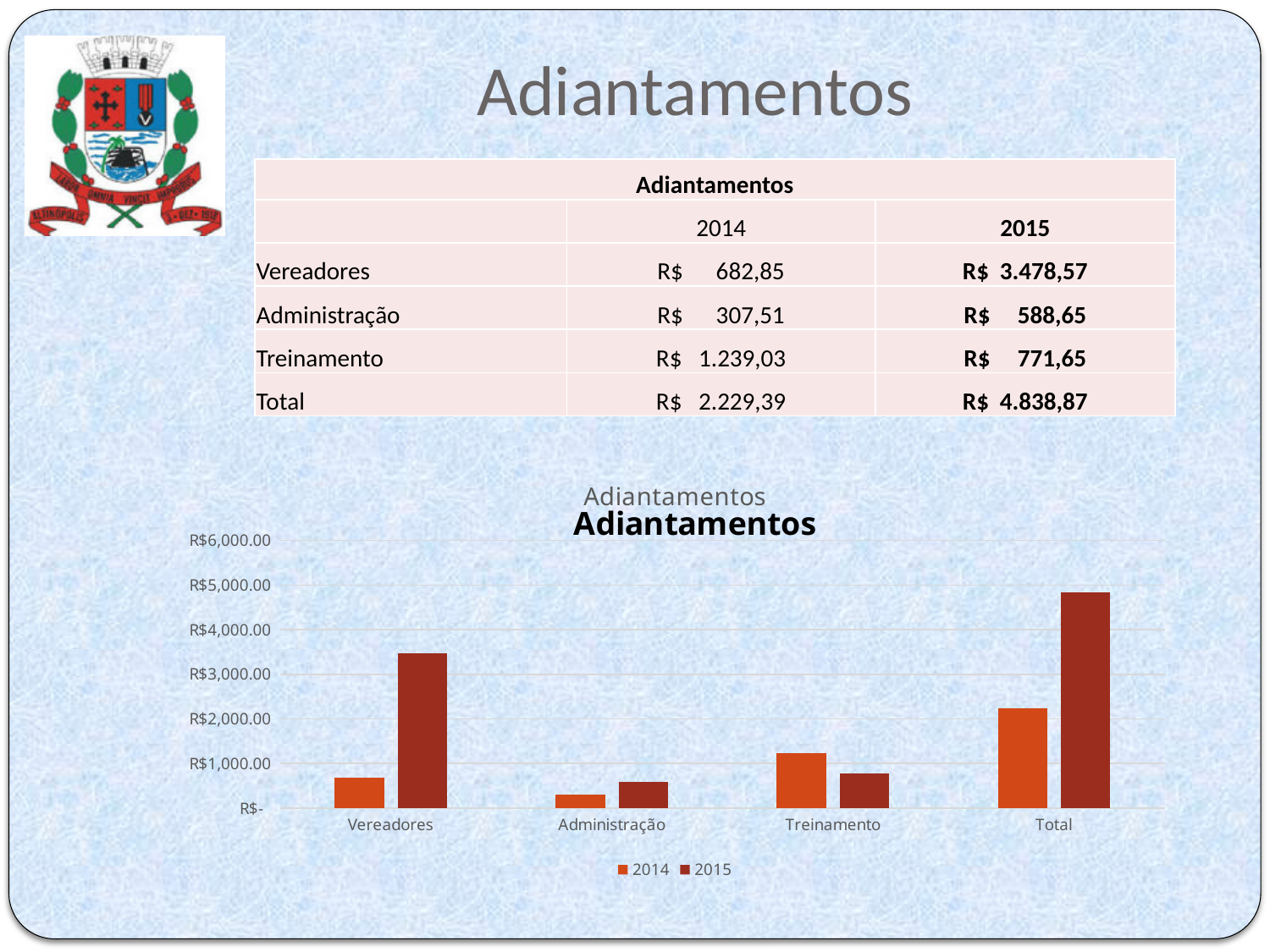
For Treinamento, which series has the larger bar, 2014 or 2015? 2014 For Vereadores, which series has the larger bar, 2014 or 2015? 2015 Is the 2015 value for Total greater or less than R$4,000.00? greater Which category has the shortest 2014 bar in the chart? Administração According to the slide, what is the 2015 value for Vereadores? R$ 3.478,57 How many series does the chart legend list? 2 Is the 2014 value for Treinamento greater or less than R$2,000.00? less How many categories are shown on the x axis of the chart? 4 Is the 2015 value for Vereadores greater or less than R$3,000.00? greater What is the title of the chart? Adiantamentos Which category has the tallest 2015 bar in the chart? Total What kind of chart is shown on the slide? bar chart